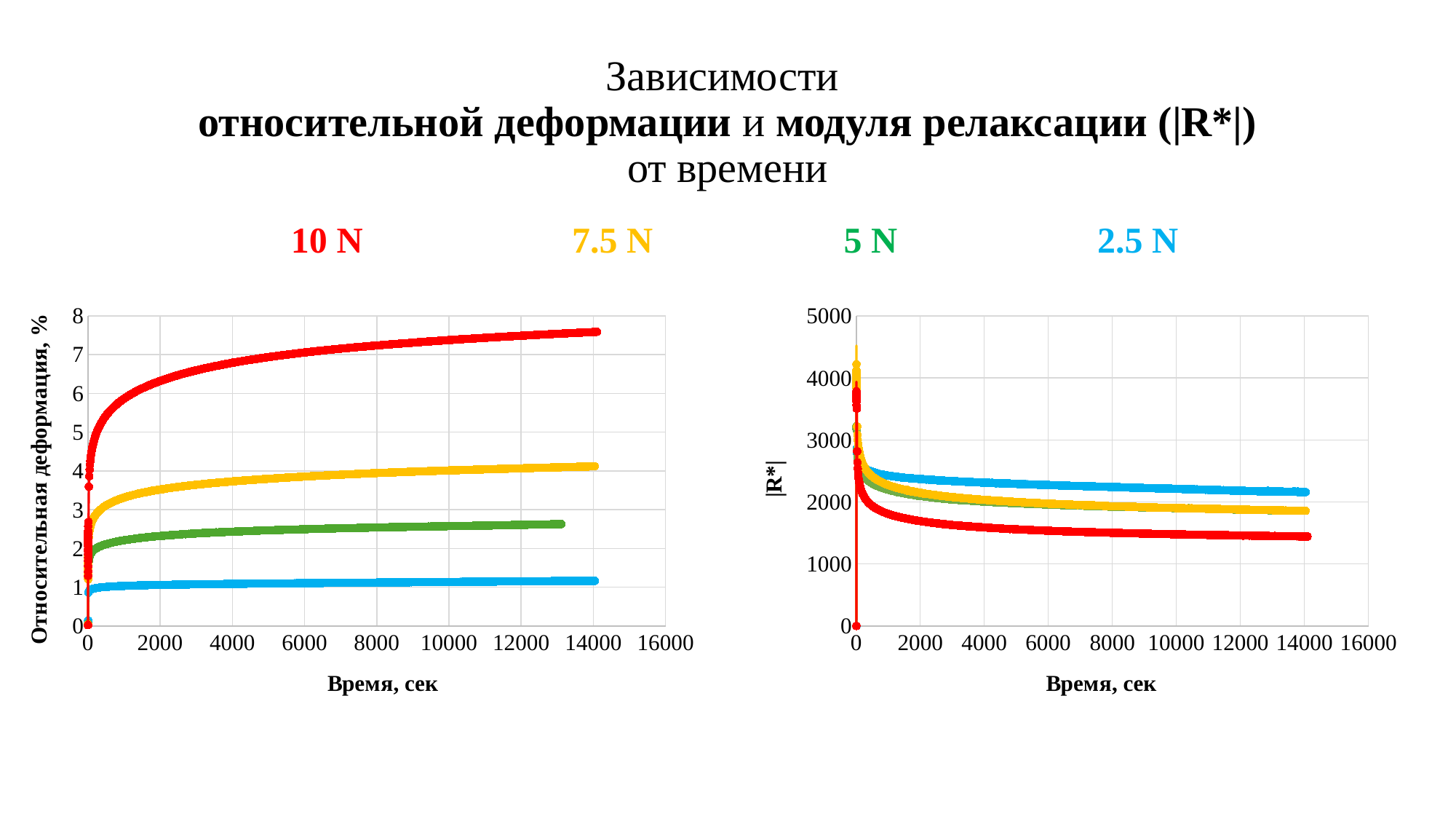
On the right chart (|R*|), do the values rise or fall as time increases? fall What is the x-axis label of the right chart (|R*|)? Время, сек On the left chart (Относительная деформация, %), is the final value for 5 N greater or less than 3? less What kind of chart is the left chart (Относительная деформация, %)? line chart On the left chart (Относительная деформация, %), do the values rise or fall as time increases? rise On the right chart (|R*|), which series has the lowest values at the end of the time range? 10 N On the left chart (Относительная деформация, %), is the final value for 10 N greater or less than 7? greater How many series (loads) are shown in the legend above the charts? 4 On the left chart (Относительная деформация, %), which series has the lowest values? 2.5 N On the right chart (|R*|), which series has the highest values at the end of the time range? 2.5 N On the right chart (|R*|), is the final value for 10 N greater or less than 2000? less On the left chart (Относительная деформация, %), which series has the highest values? 10 N